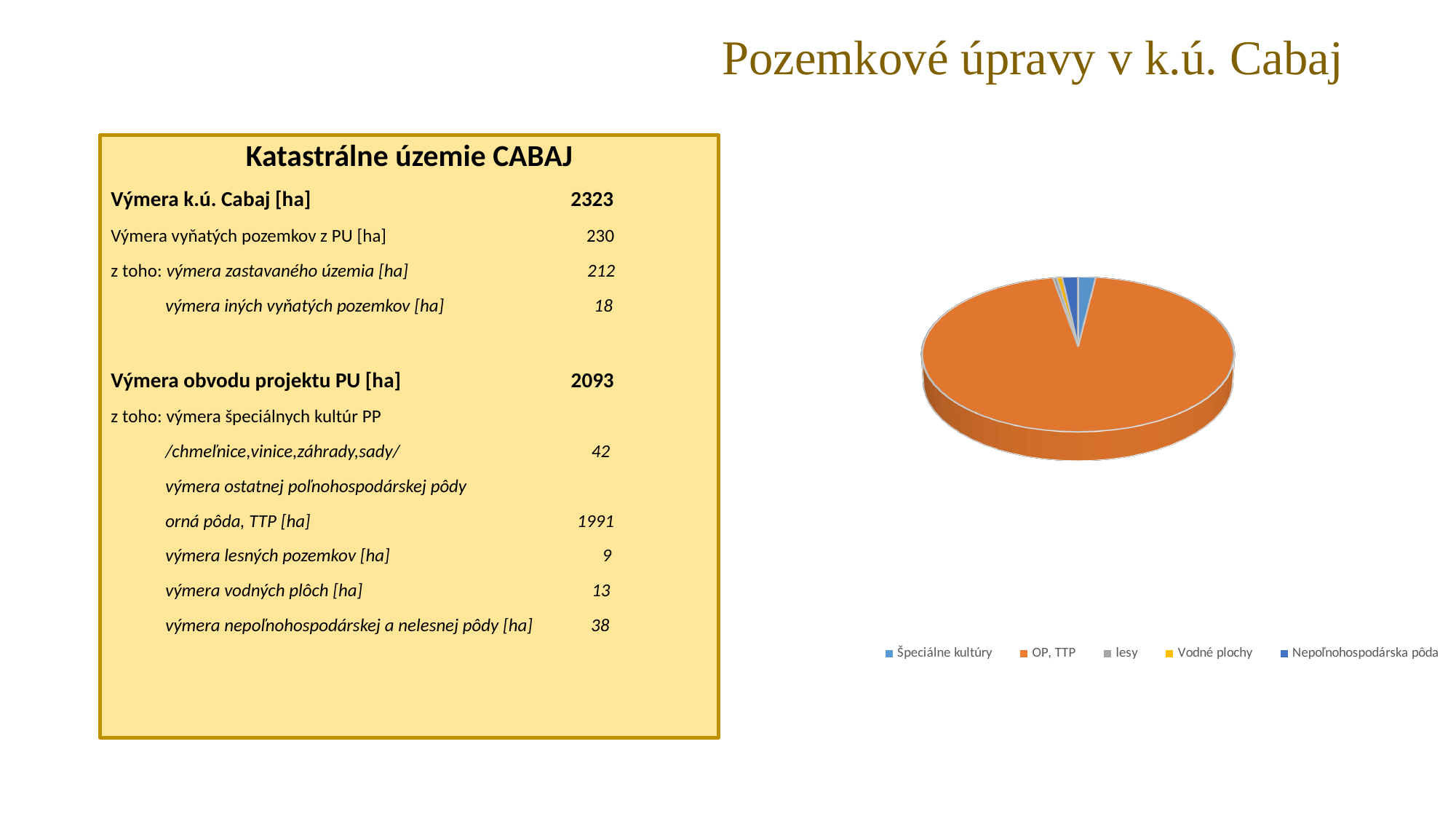
In the pie chart, which slice is larger: OP, TTP or Nepoľnohospodárska pôda? OP, TTP What is the first entry listed in the pie chart's legend? Špeciálne kultúry In the pie chart, which slice is larger: OP, TTP or Špeciálne kultúry? OP, TTP Which category has the largest slice in the pie chart? OP, TTP What colour is the largest slice of the pie chart? orange In the pie chart, which slice is larger: Špeciálne kultúry or lesy? Špeciálne kultúry How many categories does the pie chart's legend list? 5 What kind of chart is shown on the right of the slide? pie chart